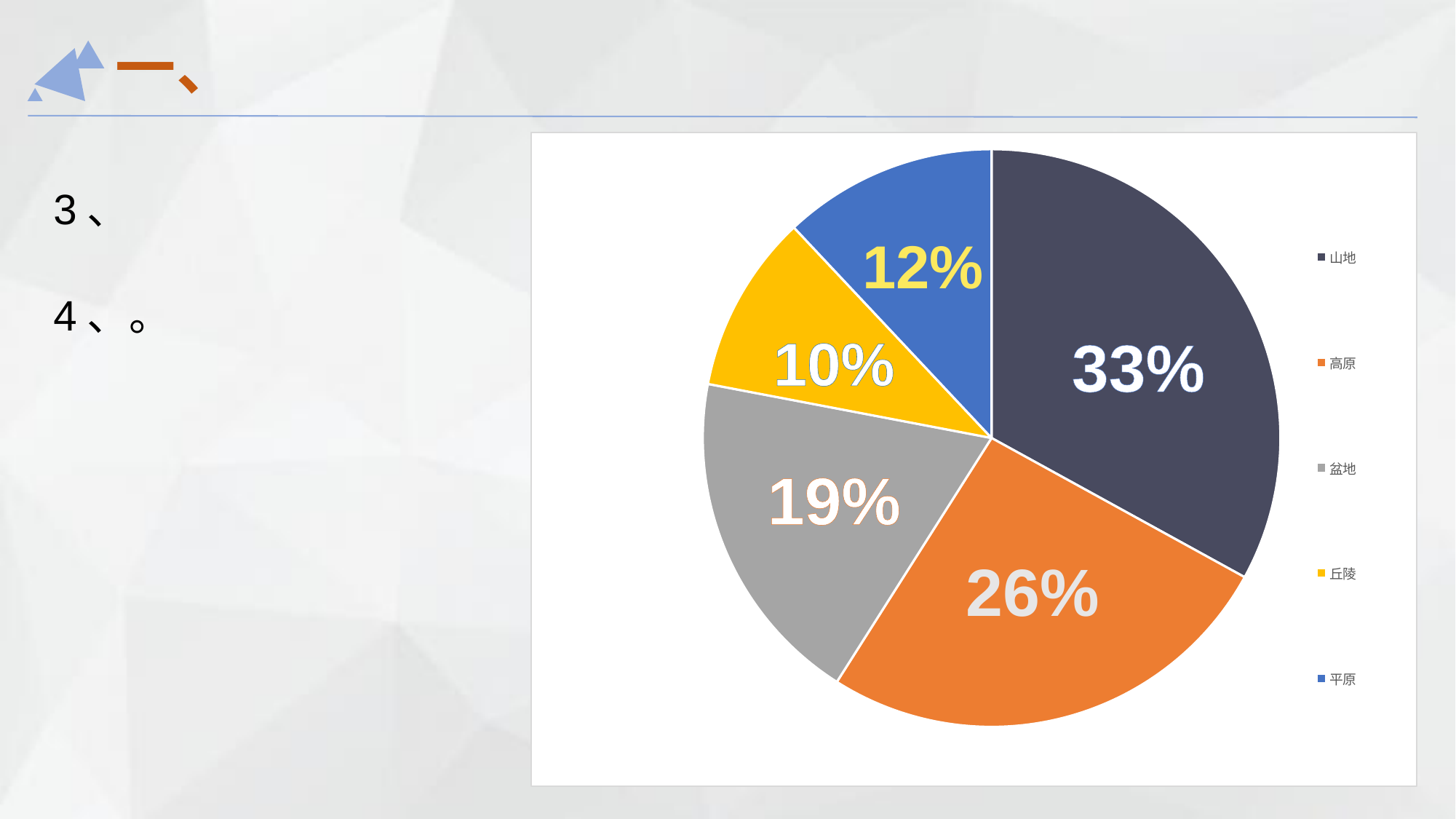
What share of the pie does 高原 represent? 26% What share of the pie does 盆地 represent? 19% What colour is the slice for 丘陵? yellow What share of the pie does 丘陵 represent? 10% What share of the pie does 山地 represent? 33% What share of the pie does 平原 represent? 12% Which is larger, the share for 盆地 or the share for 平原? 盆地 What is the difference in percentage points between 山地 and 高原? 7 What kind of chart is shown on the slide? pie chart How many categories does the pie chart show? 5 Which category has the largest slice of the pie? 山地 Which category has the smallest slice of the pie? 丘陵